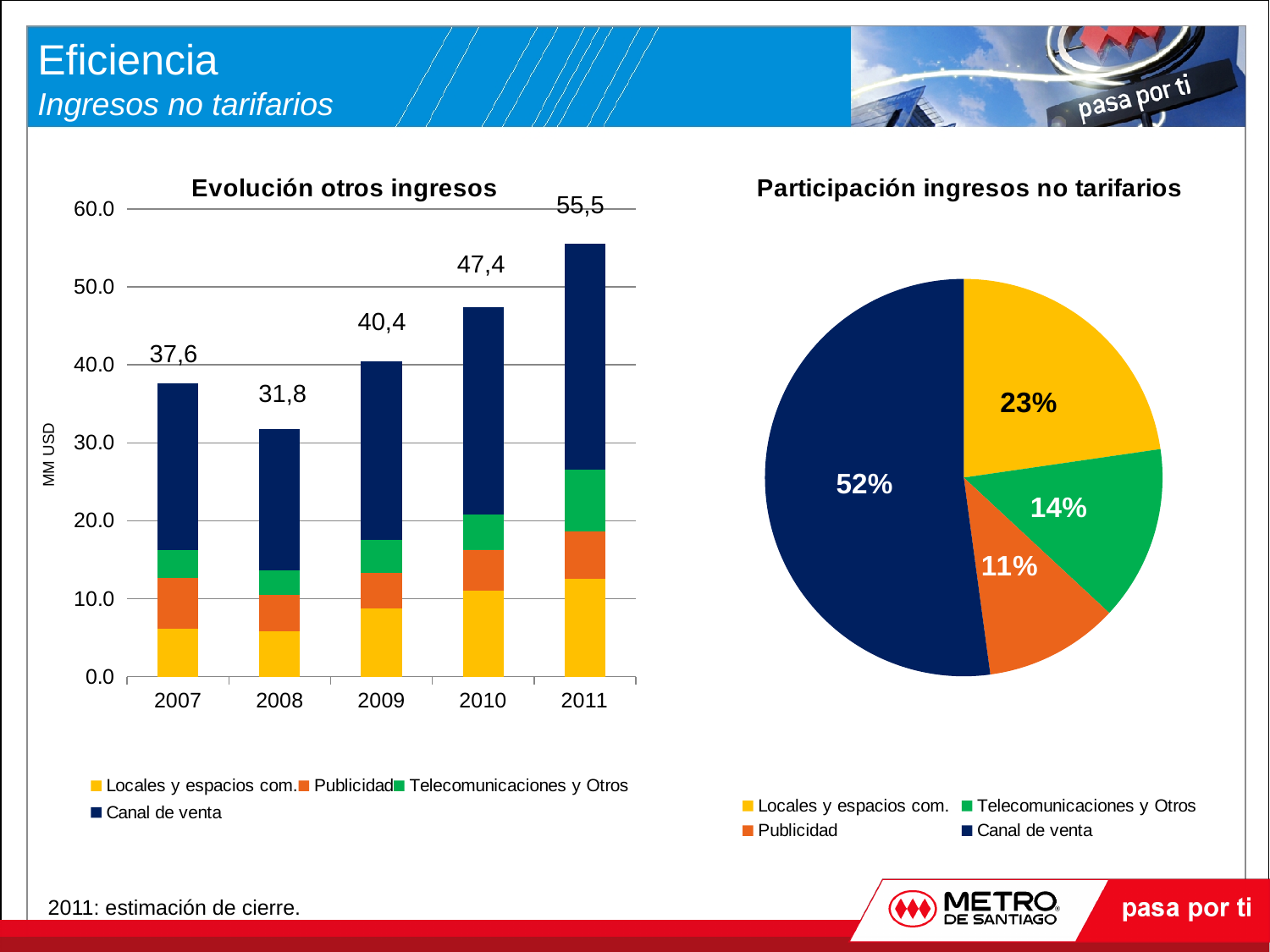
In the 'Evolución otros ingresos' chart, which year has the highest total? 2011 In the 'Evolución otros ingresos' chart, which year has the lowest total? 2008 In the 'Evolución otros ingresos' chart, what is the total value shown for 2008? 31,8 In the 'Participación ingresos no tarifarios' pie chart, what share does Publicidad have? 11% In the 'Evolución otros ingresos' chart, how many series does the legend list? 4 In the 'Participación ingresos no tarifarios' pie chart, which category has the largest share? Canal de venta In the 'Evolución otros ingresos' chart, is the total for 2009 greater or less than 40.0? greater What kind of chart is 'Evolución otros ingresos'? Stacked bar chart In the 'Evolución otros ingresos' chart, how many years are shown on the x axis? 5 In the 'Evolución otros ingresos' chart, what is the difference between the 2011 total and the 2010 total? 8,1 In the 'Participación ingresos no tarifarios' pie chart, what share does Canal de venta have? 52% In the 'Evolución otros ingresos' chart, what is the total value shown for 2011? 55,5